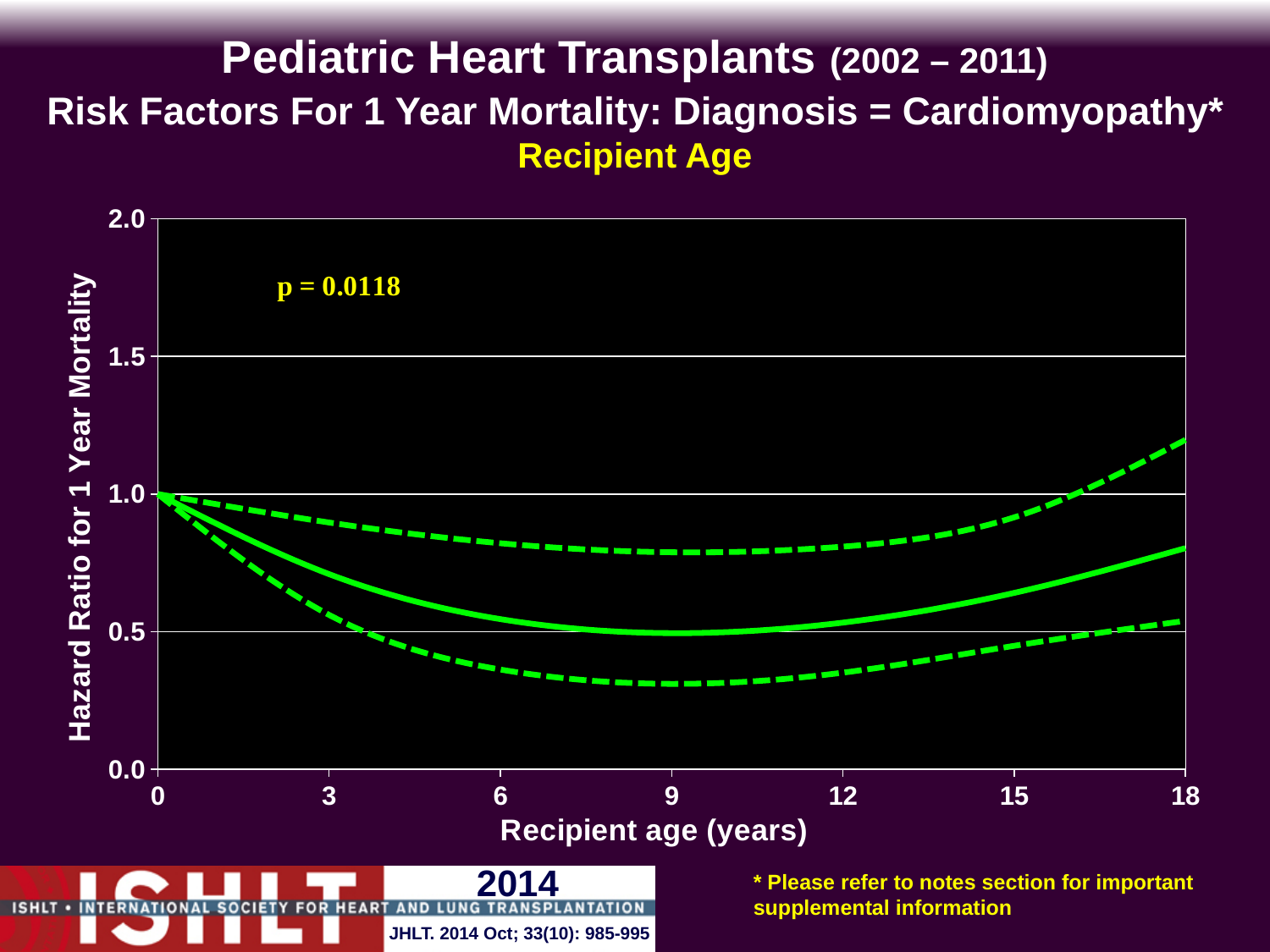
How many curves are plotted on the chart? 3 Does the solid hazard ratio line rise or fall between recipient age 0 and 9 years? Fall Is the lower dashed line at recipient age 9 years greater or less than 0.5? less Is the upper dashed line at recipient age 9 years greater or less than 1.0? less What p-value is printed on the chart? p = 0.0118 What kind of chart is shown on the slide? Line chart What is the label of the x axis? Recipient age (years) Is the upper dashed line at recipient age 18 years greater or less than 1.0? greater Does the solid hazard ratio line rise or fall between recipient age 12 and 18 years? Rise What is the hazard ratio for 1 year mortality at recipient age 0 years, where the curves begin? 1.0